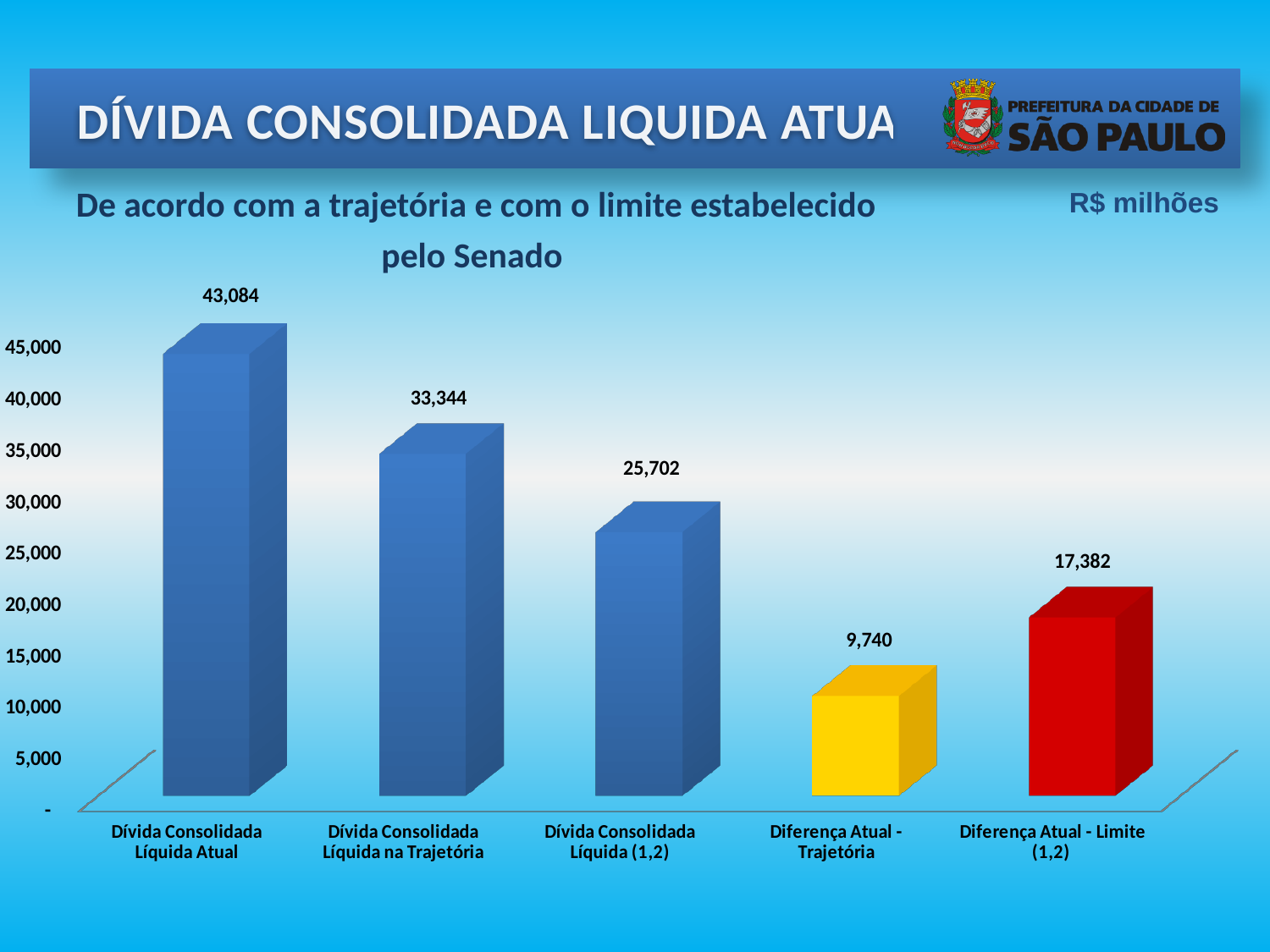
Which is larger, Diferença Atual - Trajetória or Diferença Atual - Limite (1,2)? Diferença Atual - Limite (1,2) What is the value for Diferença Atual - Trajetória? 9,740 How many categories are shown in the chart? 5 Which category has the highest value? Dívida Consolidada Líquida Atual Which category has the lowest value? Diferença Atual - Trajetória What is the difference between Dívida Consolidada Líquida Atual and Dívida Consolidada Líquida na Trajetória? 9,740 What is the value for Dívida Consolidada Líquida (1,2)? 25,702 What is the value for Dívida Consolidada Líquida Atual? 43,084 What unit is indicated for the values in the chart? R$ milhões What is the value for Dívida Consolidada Líquida na Trajetória? 33,344 What kind of chart is shown on the slide? Bar chart What is the value for Diferença Atual - Limite (1,2)? 17,382